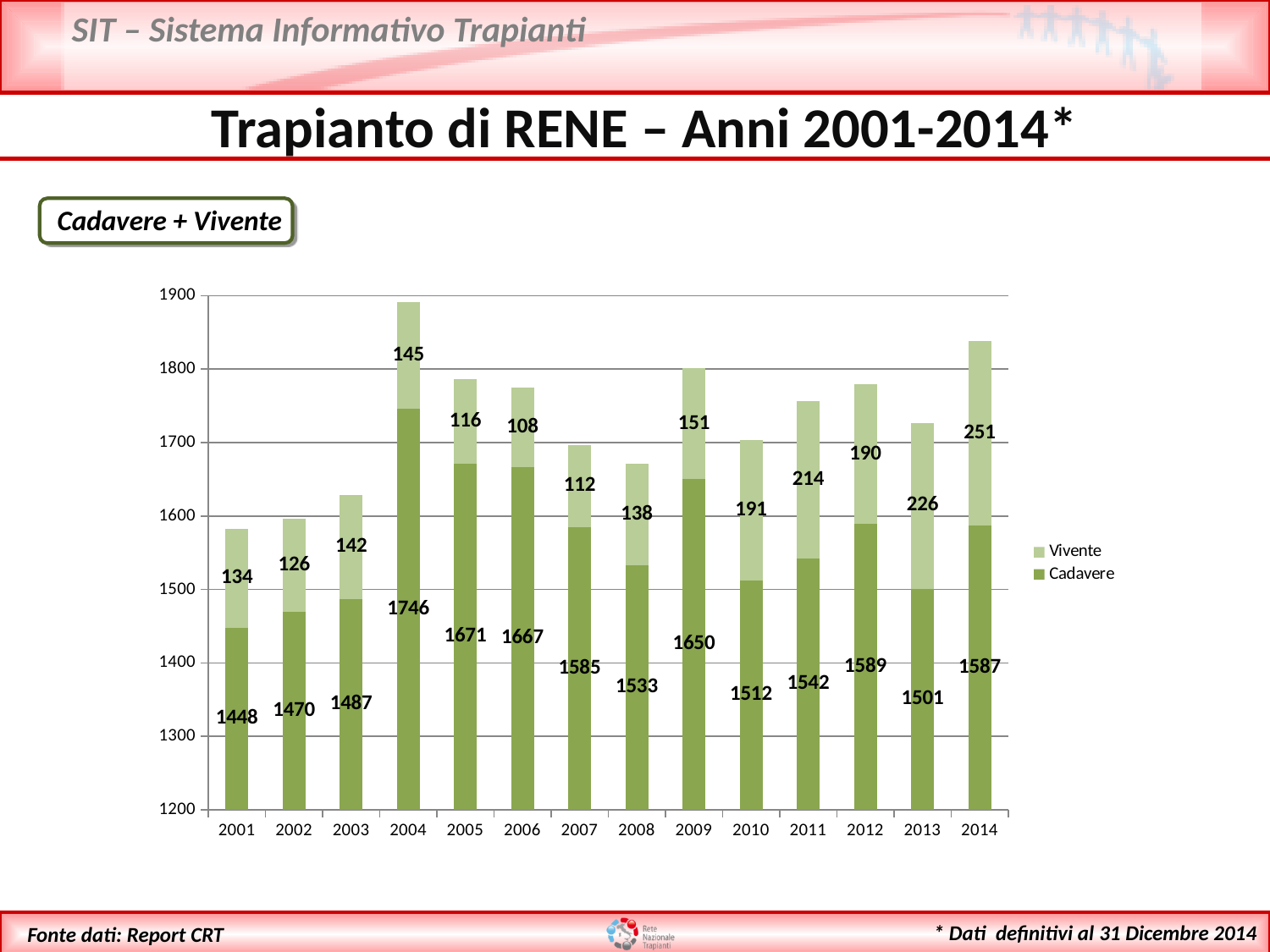
Which year has the highest Cadavere value? 2004 What is the Cadavere value for 2004? 1746 What is the total of the stacked bar for 2014 (Cadavere + Vivente)? 1838 What is the difference between the Cadavere values for 2004 and 2001? 298 Which year has the lowest Vivente value? 2006 Does the Vivente value rise or fall from 2010 to 2014? Rise How many years are shown on the x axis? 14 What is the Vivente value for 2014? 251 Which is larger, the Vivente value for 2011 or for 2012? 2011 What kind of chart is shown on the slide? Stacked bar chart Which year has the lowest Cadavere value? 2001 How many series does the legend list? 2